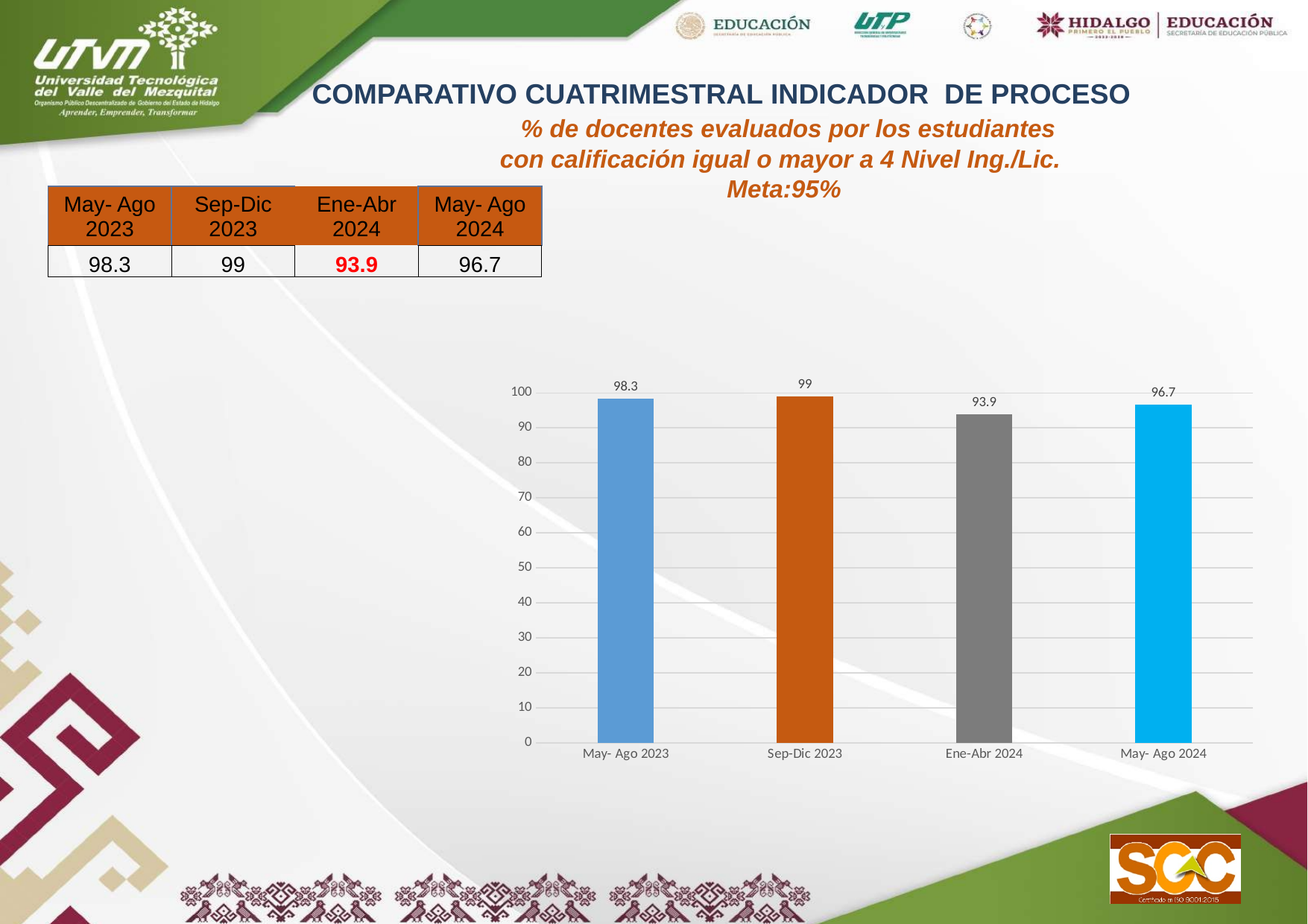
How many periods are shown on the x axis? 4 Which period has the highest value? Sep-Dic 2023 Is the value for Ene-Abr 2024 greater or less than 90? greater Which is larger, the value for May- Ago 2023 or the value for May- Ago 2024? May- Ago 2023 What is the target (Meta) stated on the slide? 95% What is the value for Sep-Dic 2023? 99 What is the value for Ene-Abr 2024? 93.9 What is the value for May- Ago 2024? 96.7 What is the difference between the values for May- Ago 2023 and Ene-Abr 2024? 4.4 Do the values rise or fall from Sep-Dic 2023 to Ene-Abr 2024? fall Which period has the lowest value? Ene-Abr 2024 What kind of chart is shown on the slide? bar chart